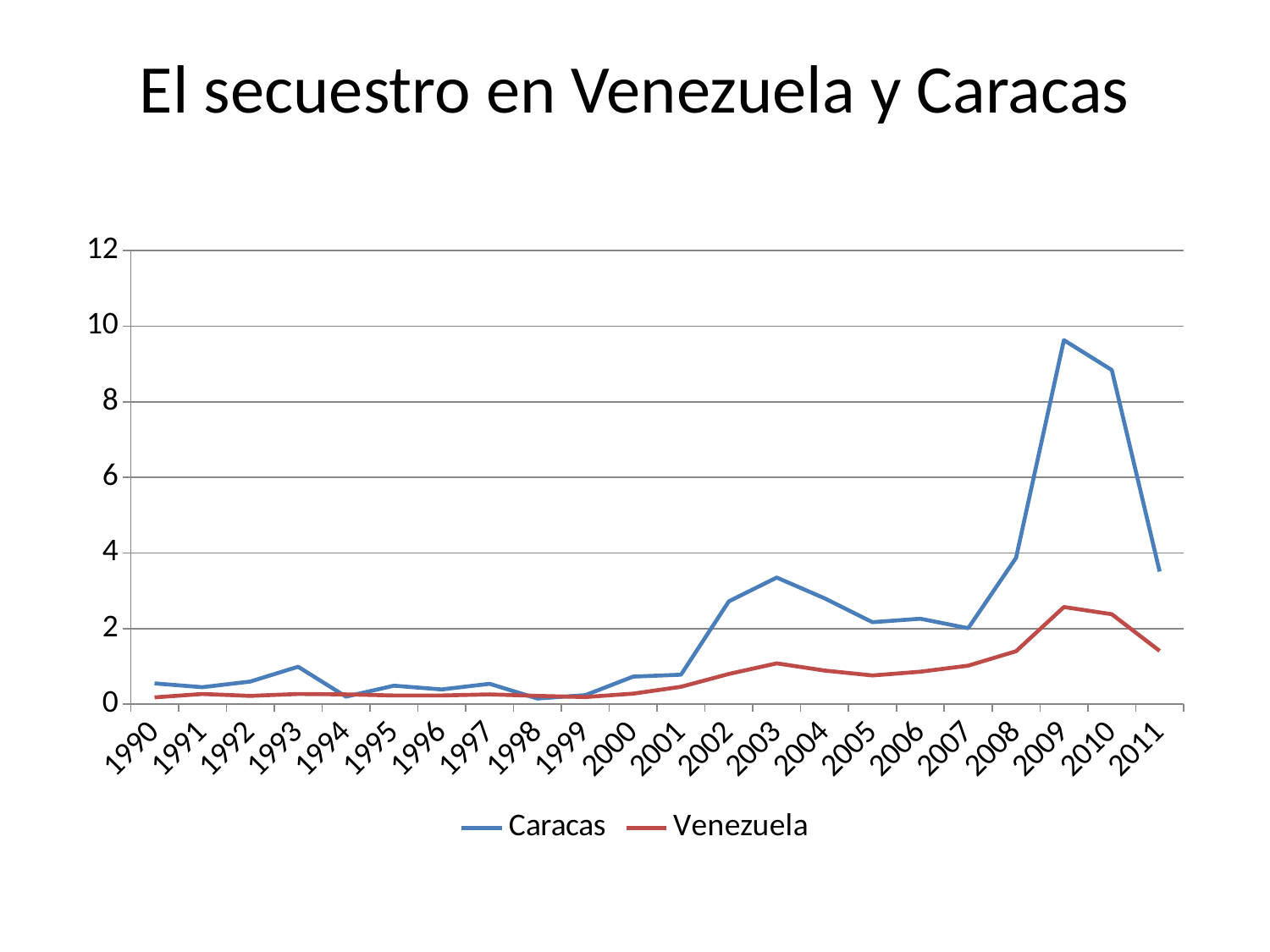
Is the value for Caracas in 2009 greater or less than 8? greater How many years are plotted along the x axis? 22 What kind of chart is shown on the slide? line chart What is the title of the chart? El secuestro en Venezuela y Caracas In which year does the Caracas series reach its highest value? 2009 How many series does the legend list? 2 Is the value for Venezuela in 2009 greater or less than 2? greater In which year does the Venezuela series reach its highest value? 2009 Does the Caracas series rise or fall from 2009 to 2011? fall Is the value for Caracas in 2003 greater or less than 2? greater Which series has the larger value in 2009, Caracas or Venezuela? Caracas